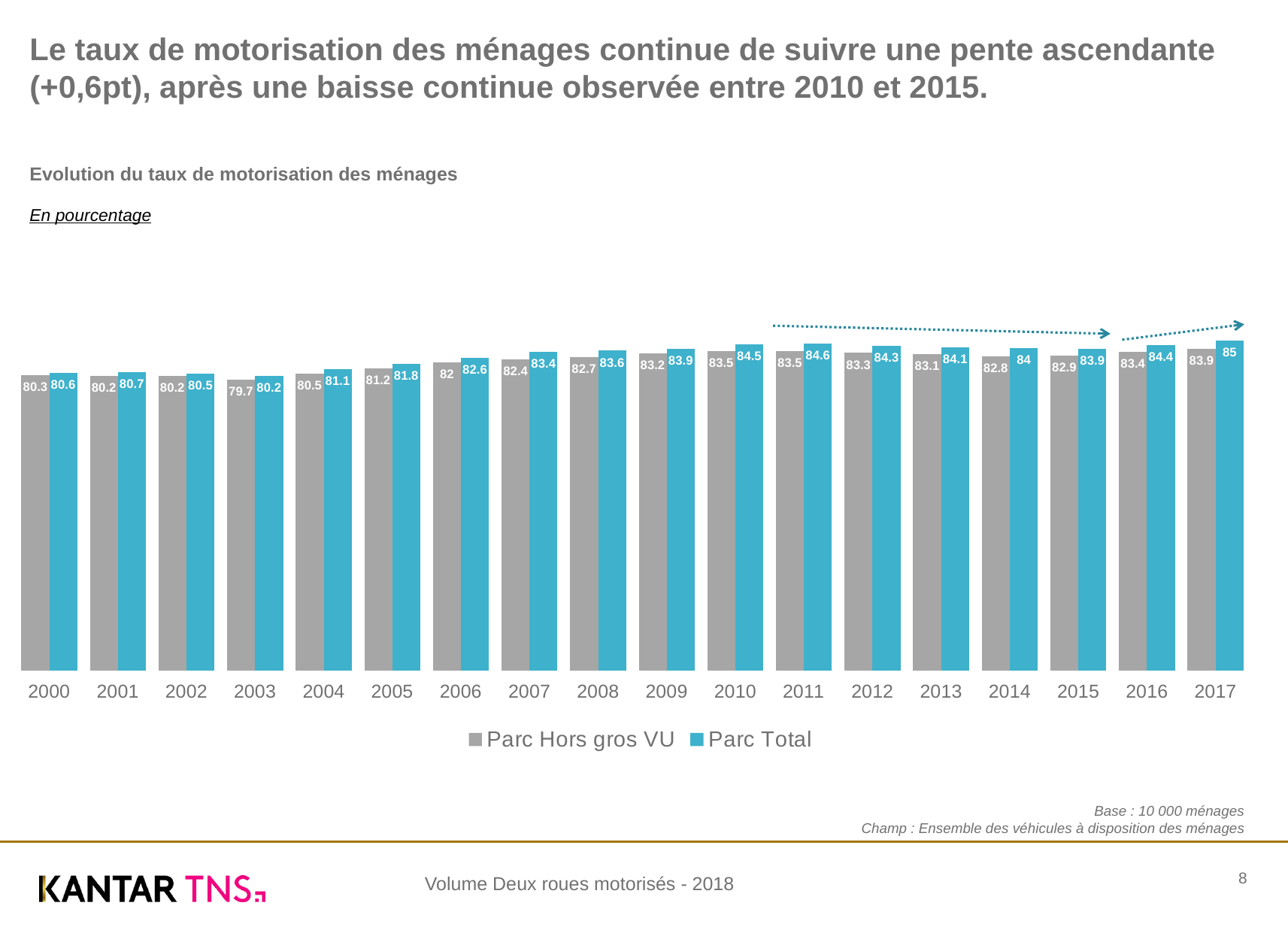
What is the value for Parc Total in 2011? 84.6 Does the Parc Total value rise or fall from 2015 to 2017? Rise What is the difference between Parc Total and Parc Hors gros VU in 2016? 1 How many series does the legend list? 2 What is the value for Parc Total in 2017? 85 What is the title of the chart? Evolution du taux de motorisation des ménages How many years are shown on the x axis? 18 Which is larger in 2010: Parc Total or Parc Hors gros VU? Parc Total Which year has the highest value for Parc Total? 2017 Which year has the lowest value for Parc Hors gros VU? 2003 What is the value for Parc Hors gros VU in 2003? 79.7 What kind of chart is shown on the slide? Bar chart